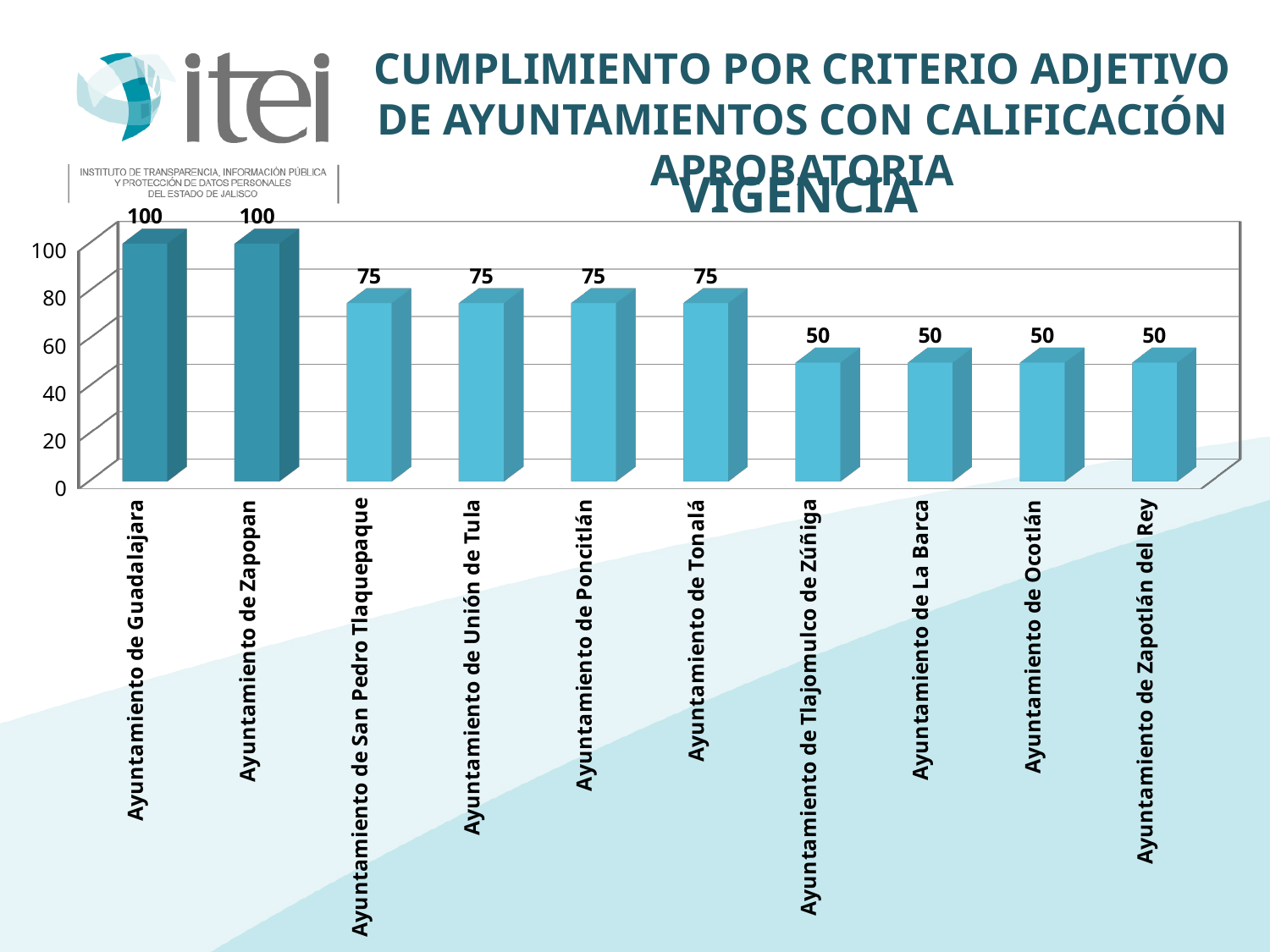
Which is larger, the value for Ayuntamiento de San Pedro Tlaquepaque or the value for Ayuntamiento de Tlajomulco de Zúñiga? Ayuntamiento de San Pedro Tlaquepaque Is the value for Ayuntamiento de Tonalá greater or less than 60? greater Do the values rise or fall from left to right along the x axis? fall What kind of chart is shown on the slide? bar chart What is the chart's title? VIGENCIA What is the value for Ayuntamiento de Zapotlán del Rey? 50 How many ayuntamientos are shown in the chart? 10 What is the difference between the values for Ayuntamiento de Zapopan and Ayuntamiento de Tonalá? 25 What is the difference between the values for Ayuntamiento de Unión de Tula and Ayuntamiento de Ocotlán? 25 What is the value for Ayuntamiento de La Barca? 50 What is the value for Ayuntamiento de Guadalajara? 100 What is the value for Ayuntamiento de Poncitlán? 75